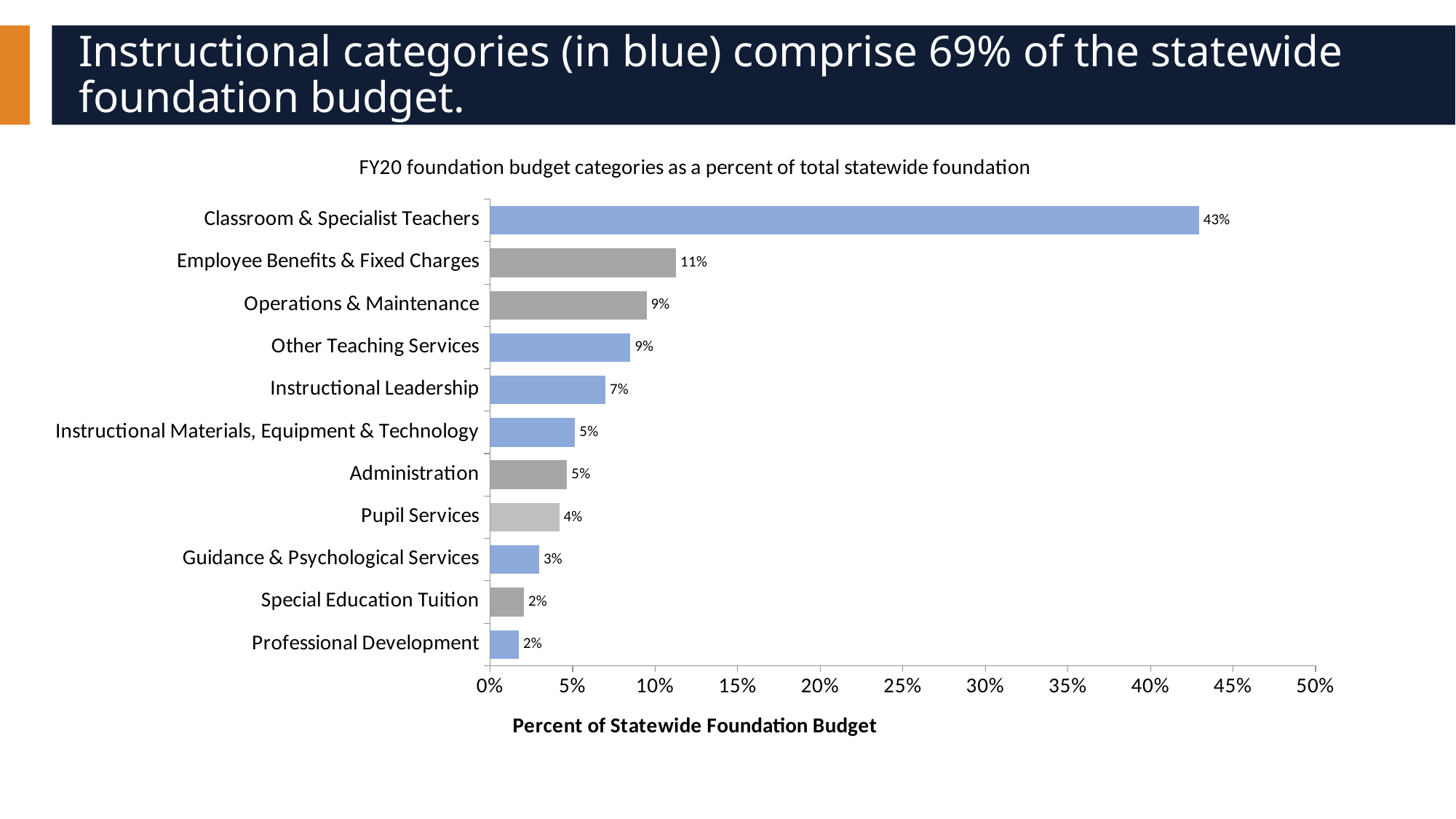
What percent of the budget is Instructional Leadership? 7% Which is larger, the value for Instructional Leadership or the value for Pupil Services? Instructional Leadership What kind of chart is shown on the slide? Bar chart Is the value for Classroom & Specialist Teachers greater or less than 40%? greater What is the value for Pupil Services? 4% How many categories are shown in the chart? 11 What is the label of the horizontal axis? Percent of Statewide Foundation Budget What is the difference between the values for Classroom & Specialist Teachers and Employee Benefits & Fixed Charges? 32% What percent of the statewide foundation budget is Classroom & Specialist Teachers? 43% What is the title of the chart? FY20 foundation budget categories as a percent of total statewide foundation Which category has the highest percent of the statewide foundation budget? Classroom & Specialist Teachers What is the value shown for Employee Benefits & Fixed Charges? 11%